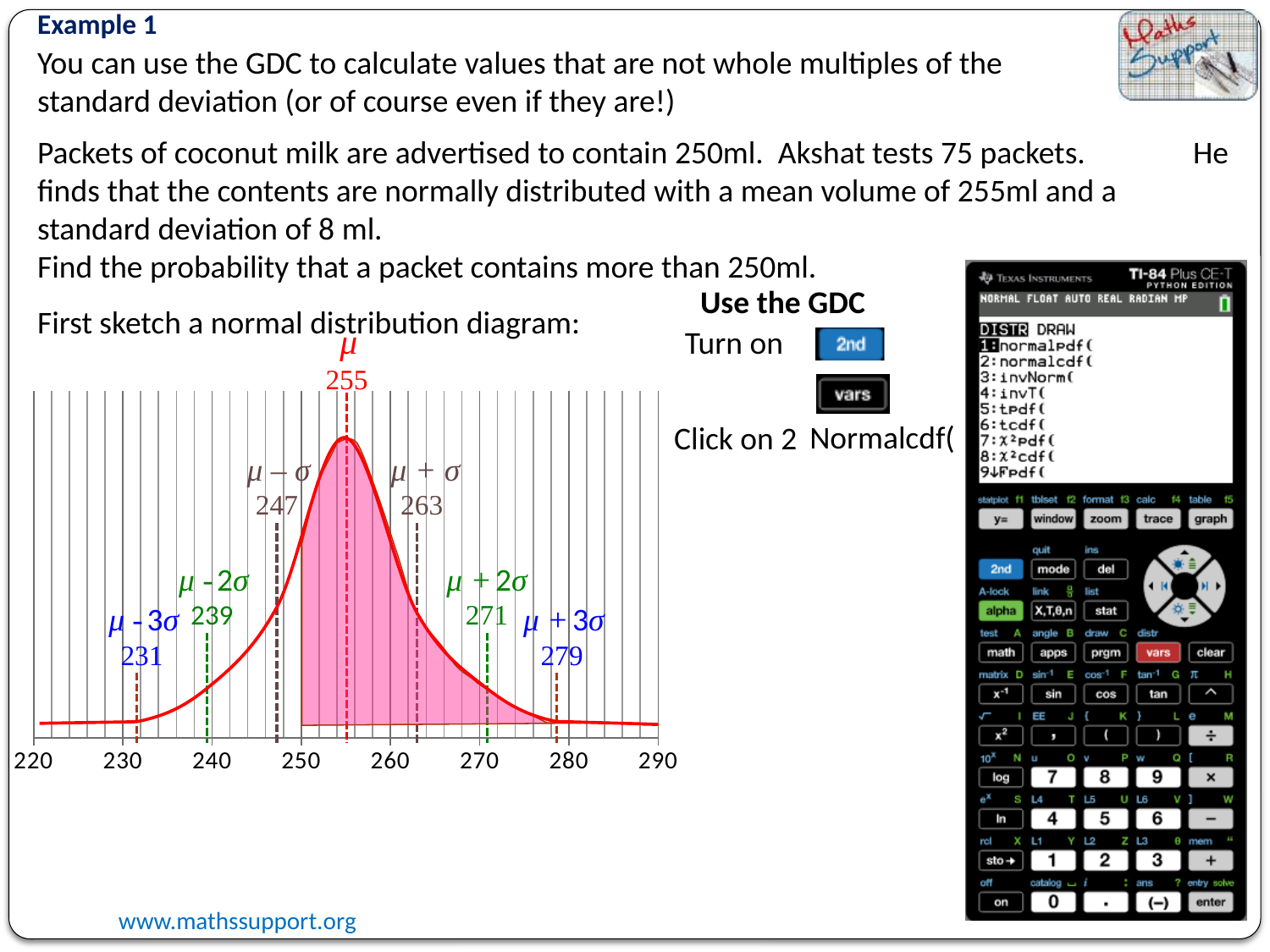
On the normal distribution diagram, what value is marked at the mean μ? 255 On the normal distribution diagram, what value is marked at μ + 3σ? 279 On the normal distribution diagram, what is the difference between the values marked at μ + 3σ and μ? 24 On the normal distribution diagram, at what x-axis value does the shaded region begin? 250 On the normal distribution diagram, what value is marked at μ + σ? 263 On the normal distribution diagram, what value is marked at μ − 3σ? 231 On the normal distribution diagram, what value is marked at μ + 2σ? 271 What kind of chart is the diagram on the slide? A normal distribution curve (line chart) How many labelled tick values are shown on the x-axis of the normal distribution diagram? 8 On the normal distribution diagram, what value is marked at μ − σ? 247 On the normal distribution diagram, what value is marked at μ − 2σ? 239 On the normal distribution diagram, what is the difference between the values marked at μ + σ and μ − σ? 16